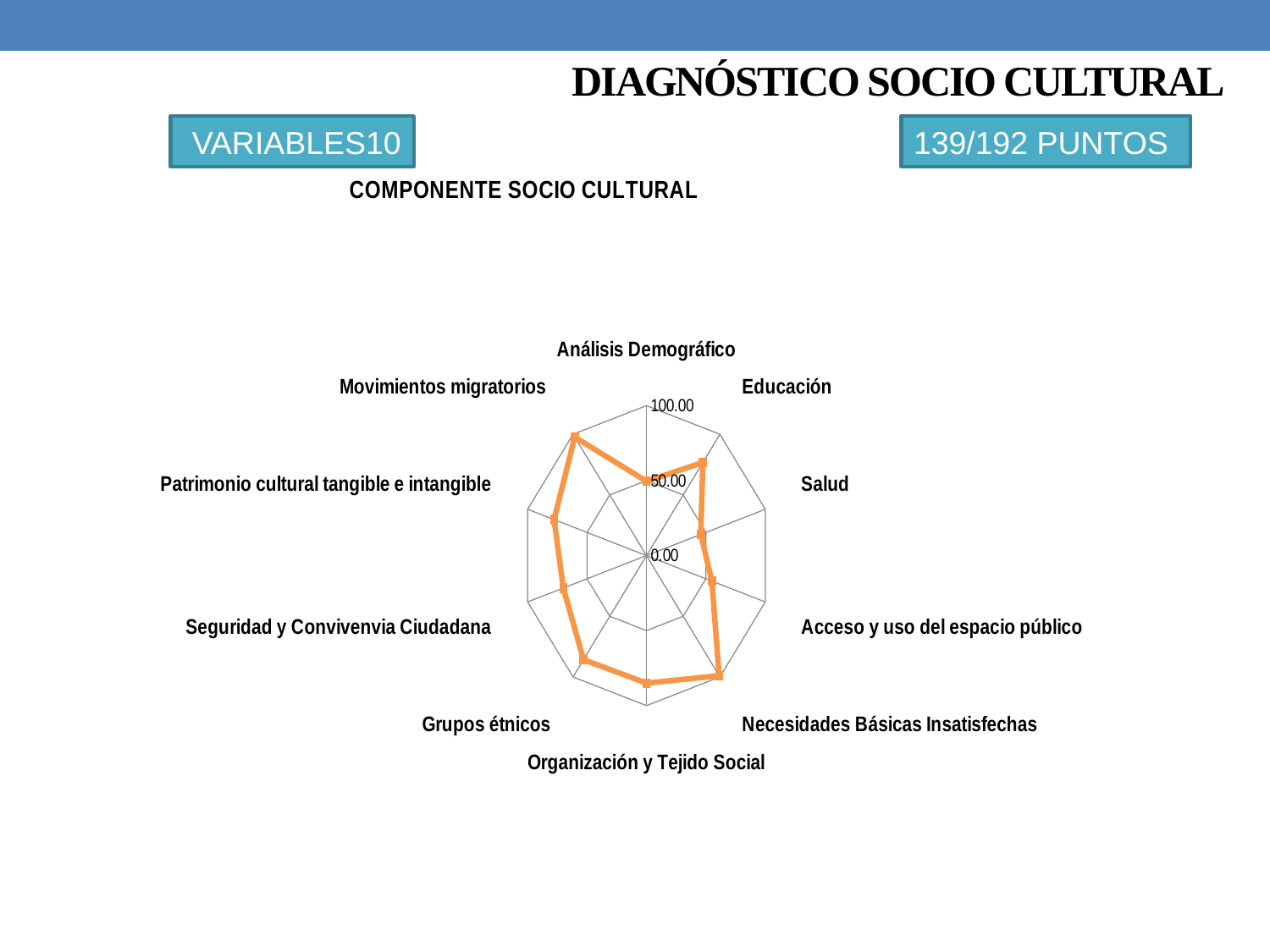
Which has the larger value, Movimientos migratorios or Análisis Demográfico? Movimientos migratorios What is the title of the chart? COMPONENTE SOCIO CULTURAL What is the highest value shown on the chart's axis scale? 100.00 Is the value for Necesidades Básicas Insatisfechas greater or less than 50? greater What kind of chart is shown on the slide? Radar chart How many categories (axes) does the radar chart have? 10 Is the value for Análisis Demográfico greater or less than 100? less Which has the larger value, Educación or Salud? Educación Is the value for Grupos étnicos greater or less than 50? greater